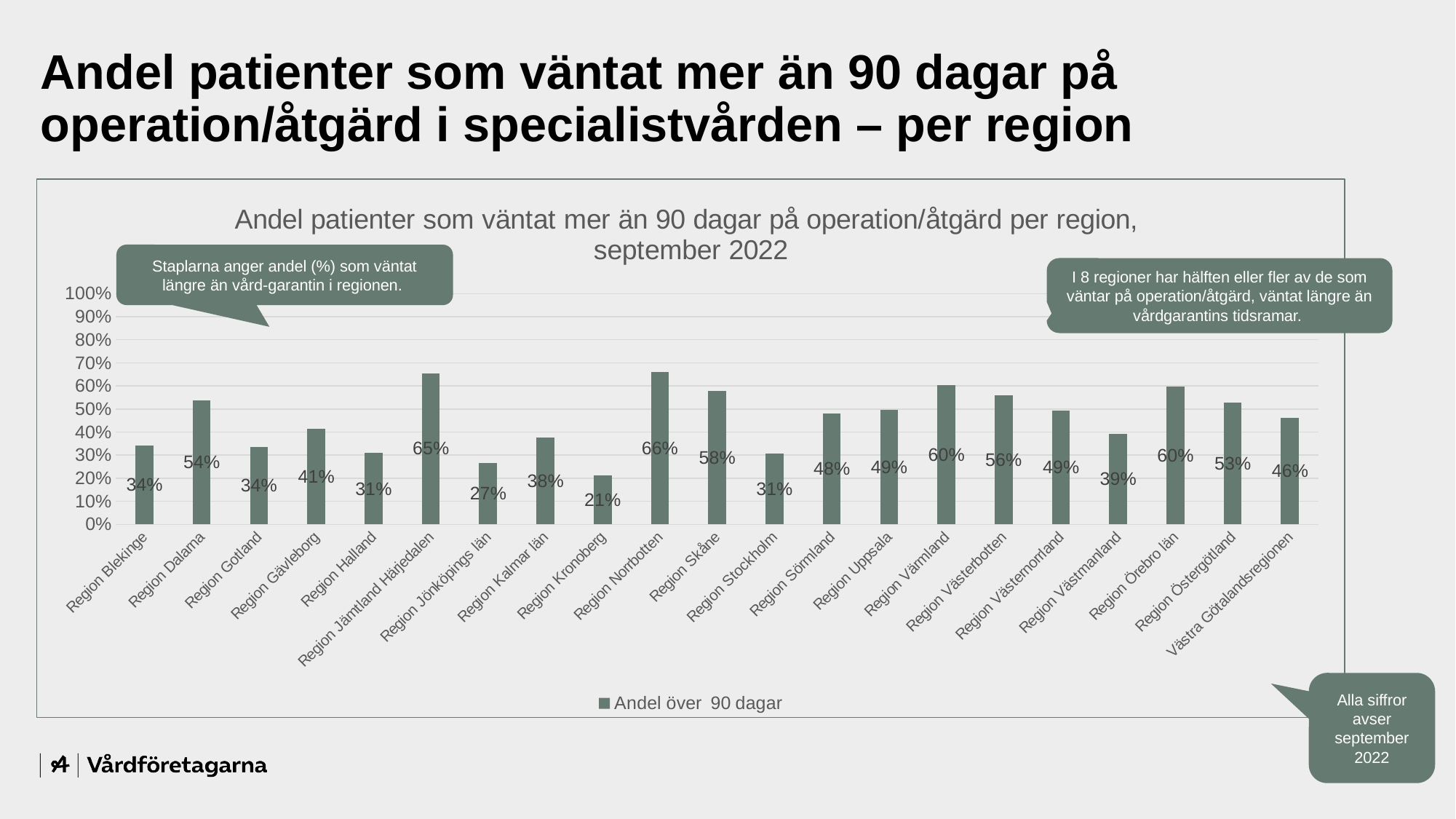
Which is larger, the value for Region Dalarna or the value for Region Gävleborg? Region Dalarna Which region has the highest value? Region Norrbotten How many series does the legend list? 1 How many regions are shown on the x axis? 21 What is the difference between the values for Region Skåne and Region Halland? 27% What is the value for Region Jämtland Härjedalen? 65% What is the value for Region Stockholm? 31% What is the value for Västra Götalandsregionen? 46% Is the value for Region Värmland greater or less than 50%? greater What kind of chart is shown? Bar chart What is the value for Region Kronoberg? 21% Which region has the lowest value? Region Kronoberg